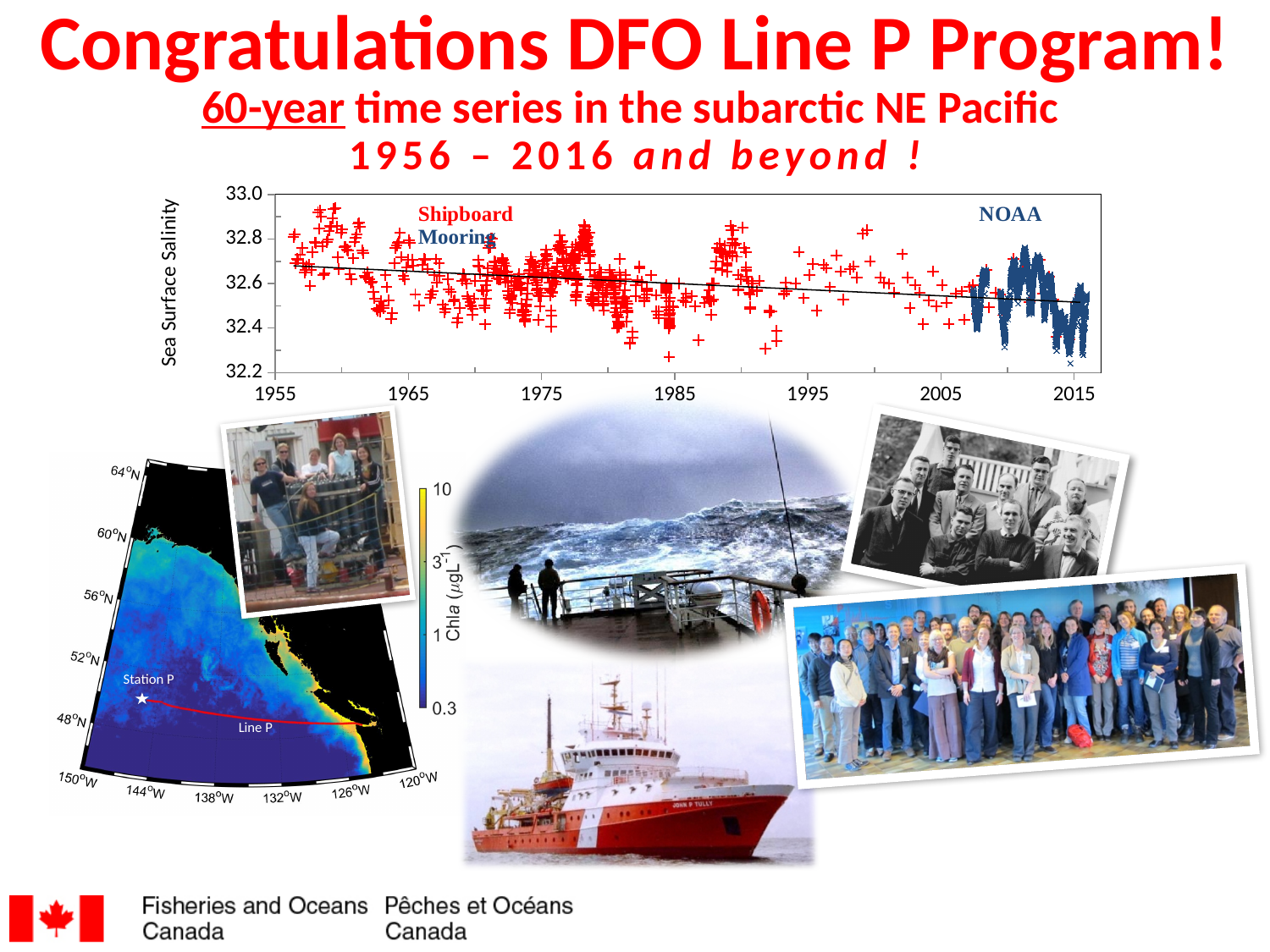
How many data series does the Sea Surface Salinity chart show? 2 Does the fitted trend line in the Sea Surface Salinity chart rise or fall from 1955 to 2015? fall What kind of chart is the Sea Surface Salinity chart? scatter chart Is the trend line value for Sea Surface Salinity near 2015 greater or less than 32.6? less What is the label on the vertical axis of the salinity chart? Sea Surface Salinity Is the trend line value for Sea Surface Salinity near 1957 greater or less than 32.6? greater Which series in the salinity chart is plotted in blue? NOAA Mooring